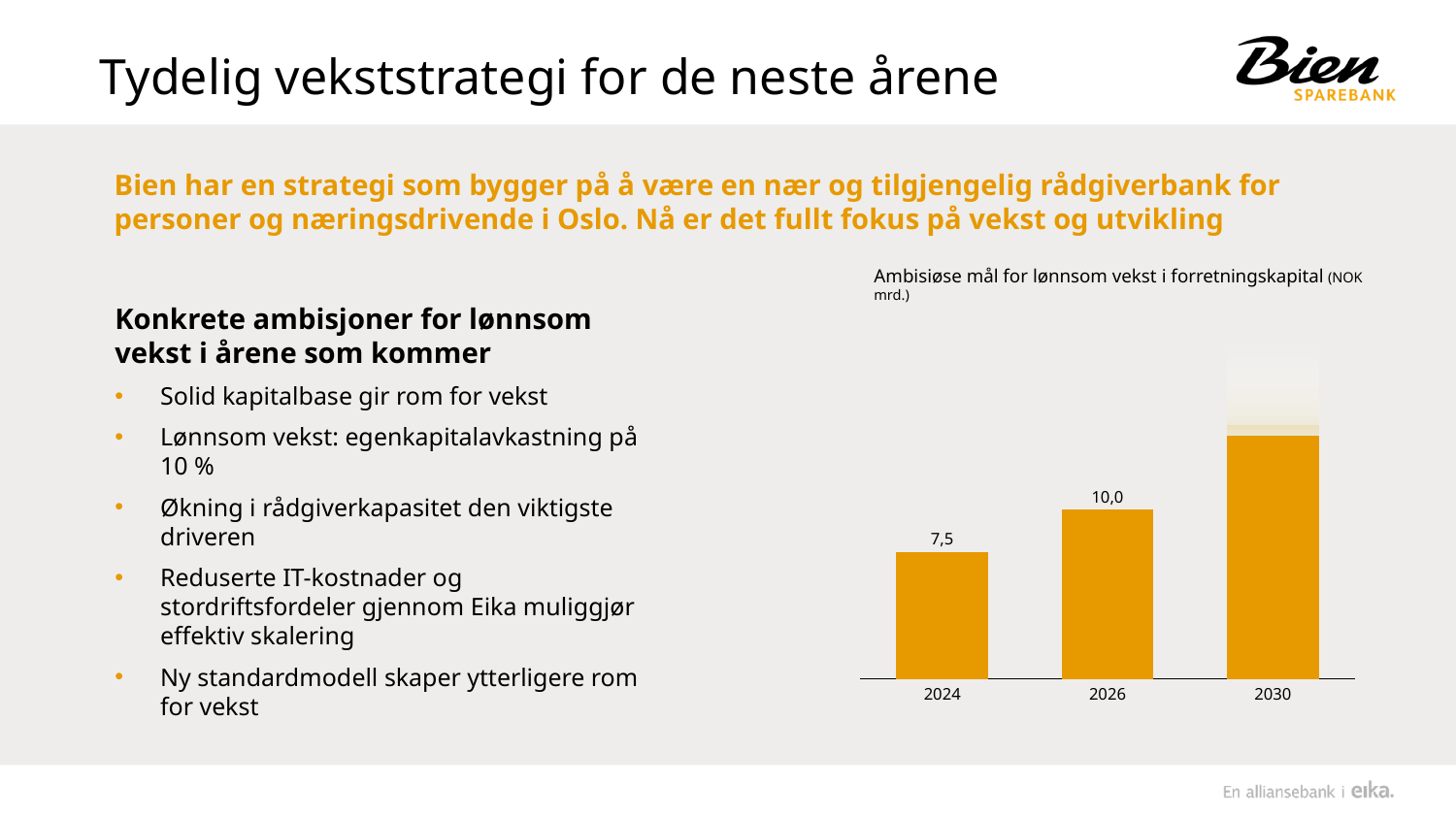
How many years are shown on the x axis of the chart? 3 Which year has the lowest bar in the chart? 2024 Which is larger, the value for 2026 or the value for 2024? 2026 What is the title of the chart? Ambisiøse mål for lønnsom vekst i forretningskapital (NOK mrd.) What is the value for 2026 in the chart? 10,0 What is the difference between the values for 2026 and 2024? 2,5 Do the values rise or fall from 2024 to 2030? Rise What kind of chart is shown on the slide? Bar chart In what unit are the chart values given? NOK mrd. Which year has the highest bar in the chart? 2030 What is the value for 2024 in the chart? 7,5